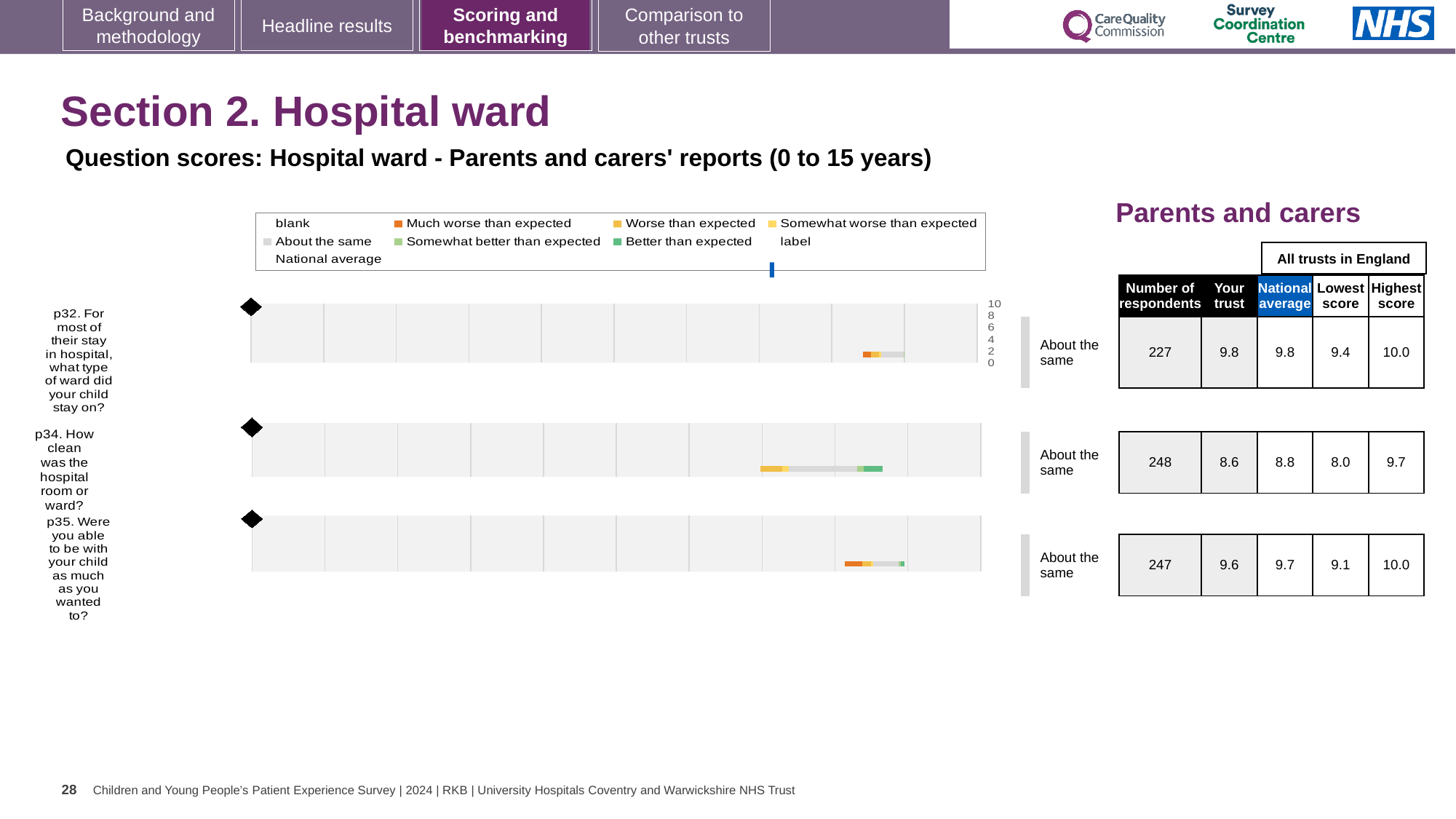
For p35, is the 'Your trust' score higher or lower than the national average? lower What benchmark category is shown for p35 (Were you able to be with your child as much as you wanted to)? About the same Is the 'Your trust' value for p34 greater or less than 8? greater How many respondents answered p32 (what type of ward did your child stay on)? 227 What is the 'Your trust' score for p34 (How clean was the hospital room or ward)? 8.6 How many questions are plotted in the chart? 3 Which question has the lowest 'Your trust' score? p34 What is the difference between the national average and the 'Your trust' score for p34? 0.2 What kind of chart is used to show the question scores on this slide? bar chart Which question has the highest 'Your trust' score? p32 What is the highest score across all trusts in England for p34? 9.7 What colour does the legend use for 'Much worse than expected'? orange